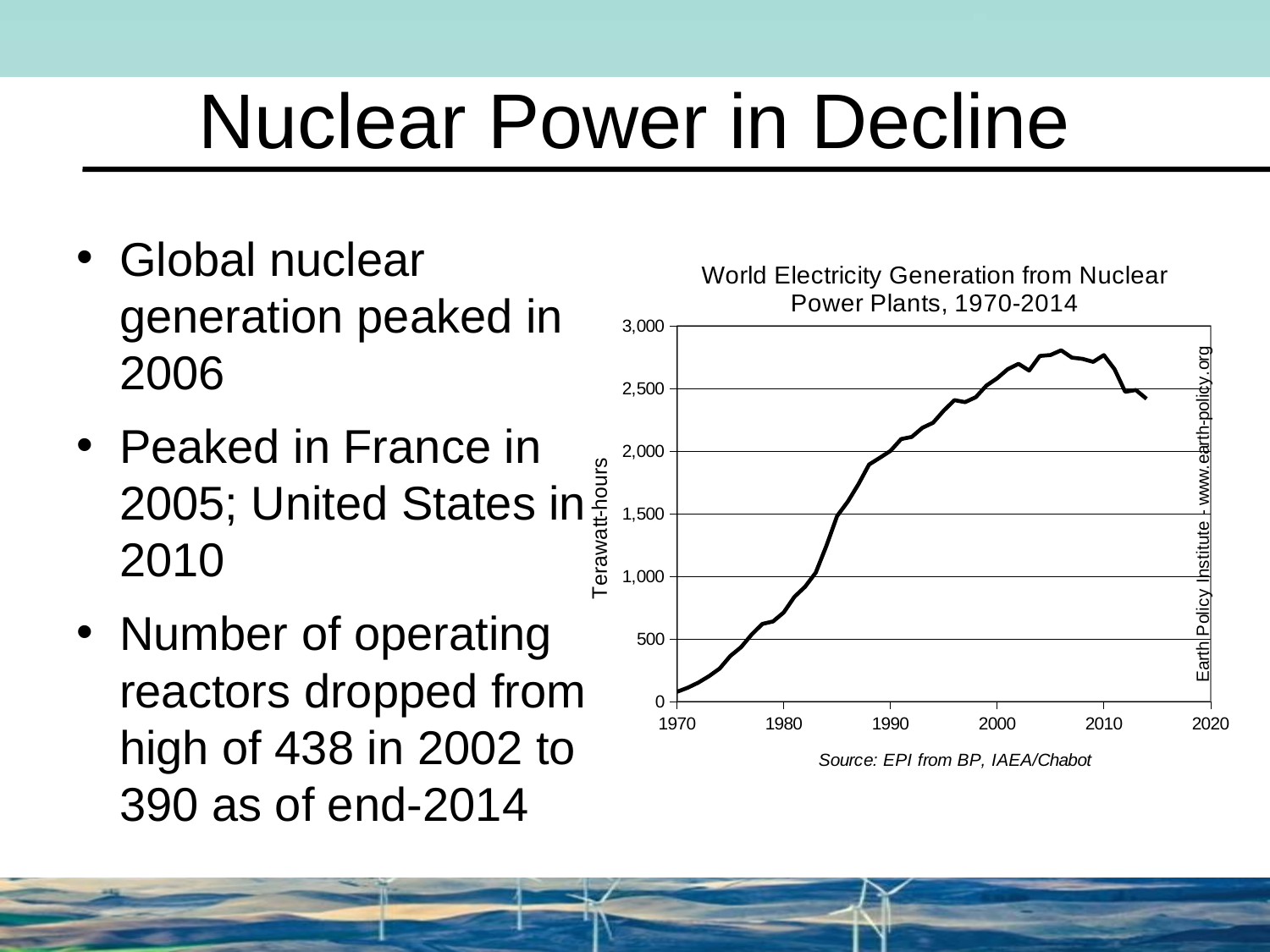
How many data series are plotted on the chart? 1 Is the value for 2014 greater or less than 2,000? greater Is the value for 1970 greater or less than 500? less Is the value for 1990 greater or less than 1,500? greater Do the values rise or fall between 1970 and 2000? rise Which year has the larger value, 1980 or 2000? 2000 Do the values rise or fall between 2010 and 2014? fall What kind of chart is shown on the slide? line chart What is the title of the chart? World Electricity Generation from Nuclear Power Plants, 1970-2014 What unit is shown on the vertical axis of the chart? Terawatt-hours